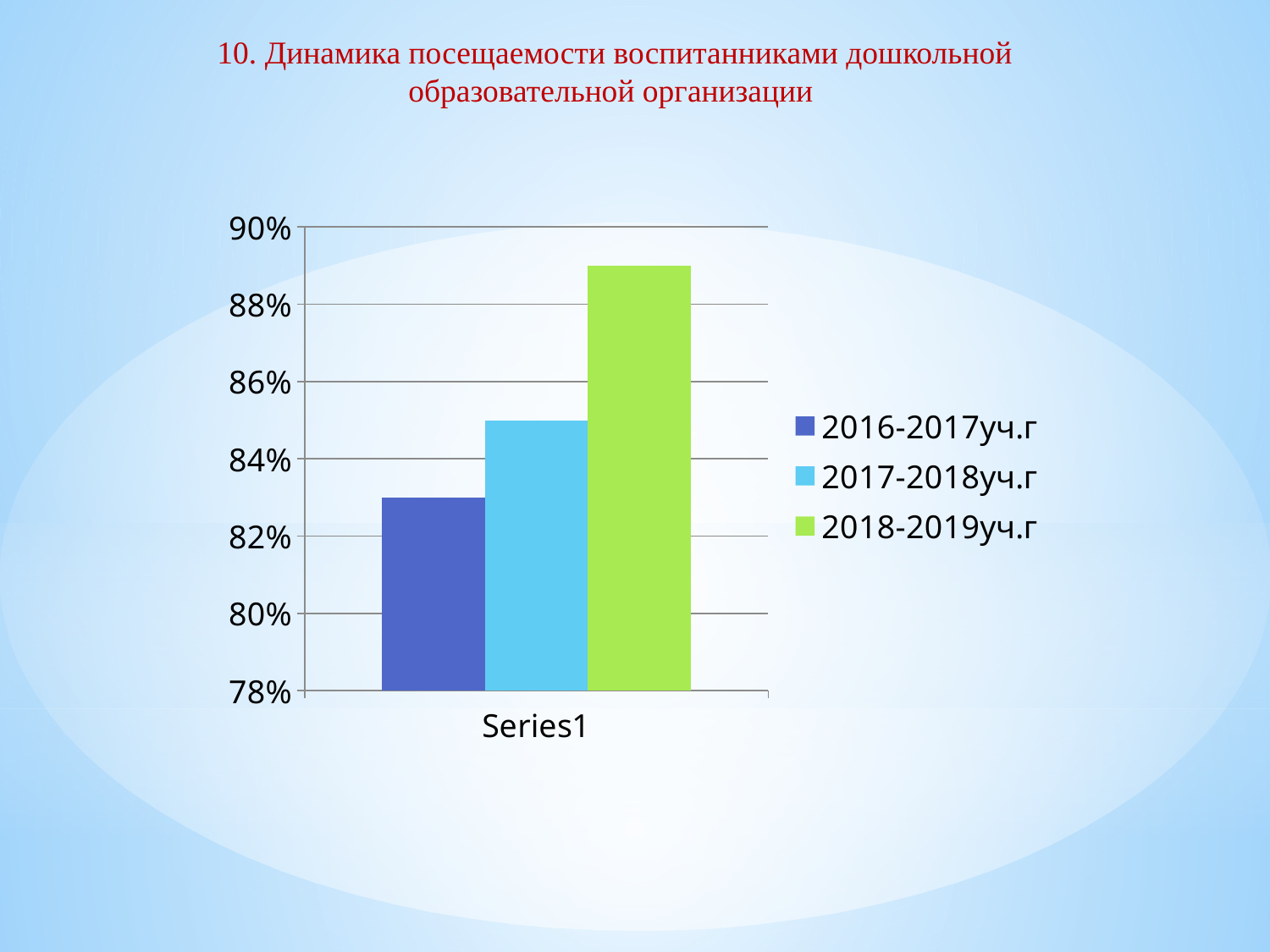
Is the value for 2016-2017уч.г greater or less than 84%? less Is the value for 2016-2017уч.г greater or less than 82%? greater Do the bars rise or fall from 2016-2017уч.г to 2018-2019уч.г? rise What kind of chart is shown on the slide? bar chart What colour is the bar for 2018-2019уч.г? green Is the value for 2017-2018уч.г greater or less than 84%? greater Which is larger, the value for 2016-2017уч.г or the value for 2017-2018уч.г? 2017-2018уч.г How many series does the legend list? 3 Which series has the highest bar? 2018-2019уч.г What is the category label shown on the x axis? Series1 Which series has the lowest bar? 2016-2017уч.г